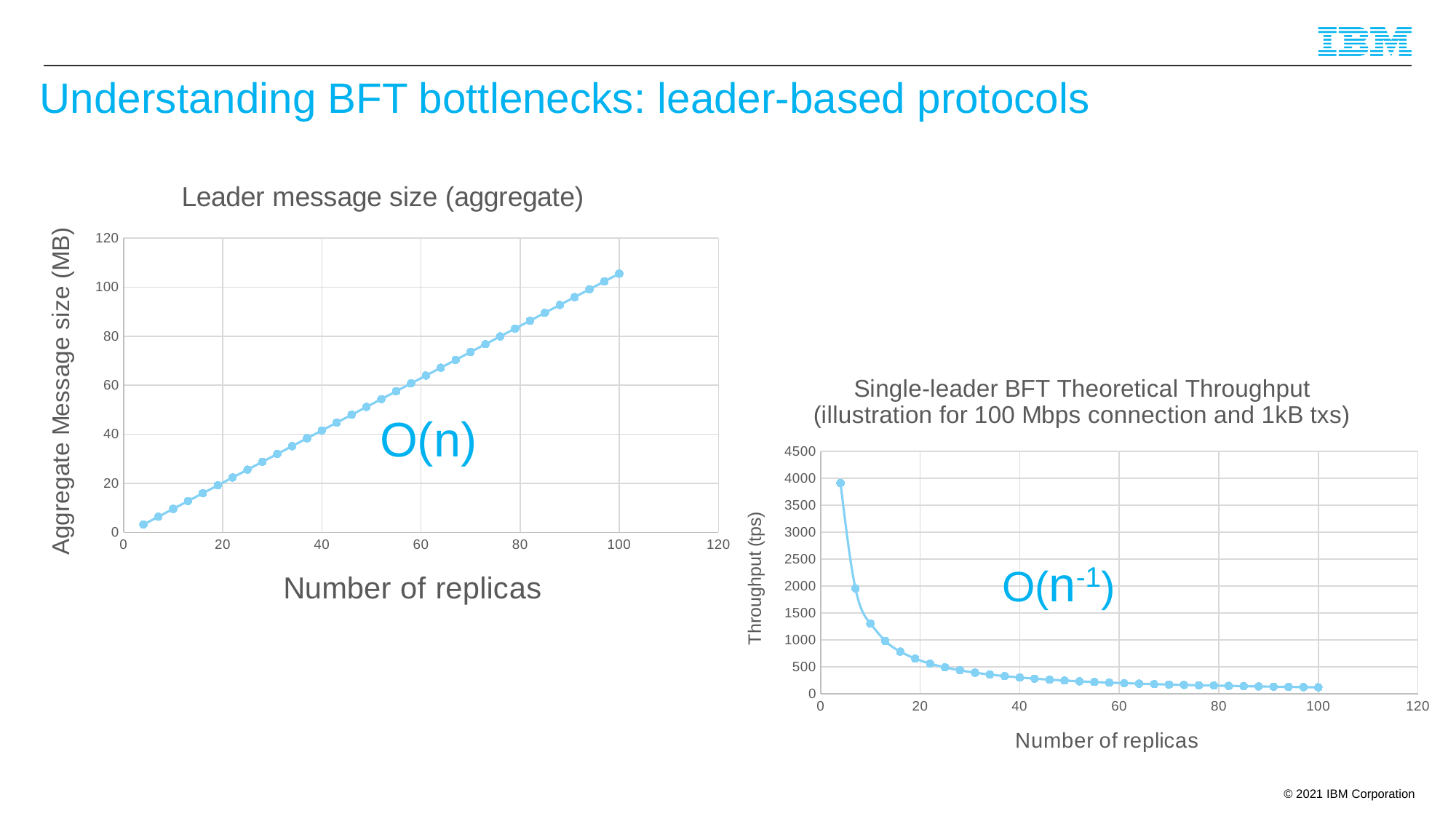
In the "Leader message size (aggregate)" chart, do the values rise or fall as the number of replicas increases? rise In the "Leader message size (aggregate)" chart, at which number of replicas is the aggregate message size highest? 100 In the "Single-leader BFT Theoretical Throughput" chart, which of the two values is larger: throughput at 20 replicas or at 80 replicas? 20 replicas What complexity annotation is printed on the "Single-leader BFT Theoretical Throughput" chart? O(n⁻¹) What is the label of the y axis of the "Leader message size (aggregate)" chart? Aggregate Message size (MB) In the "Leader message size (aggregate)" chart, is the aggregate message size at 100 replicas greater or less than 100 MB? greater What kind of chart is the "Single-leader BFT Theoretical Throughput" chart? line chart In the "Single-leader BFT Theoretical Throughput" chart, is the throughput at 100 replicas greater or less than 500 tps? less In the "Single-leader BFT Theoretical Throughput" chart, is the throughput at 40 replicas greater or less than 500 tps? less In the "Single-leader BFT Theoretical Throughput" chart, do the values rise or fall as the number of replicas increases? fall What kind of chart is the "Leader message size (aggregate)" chart? line chart